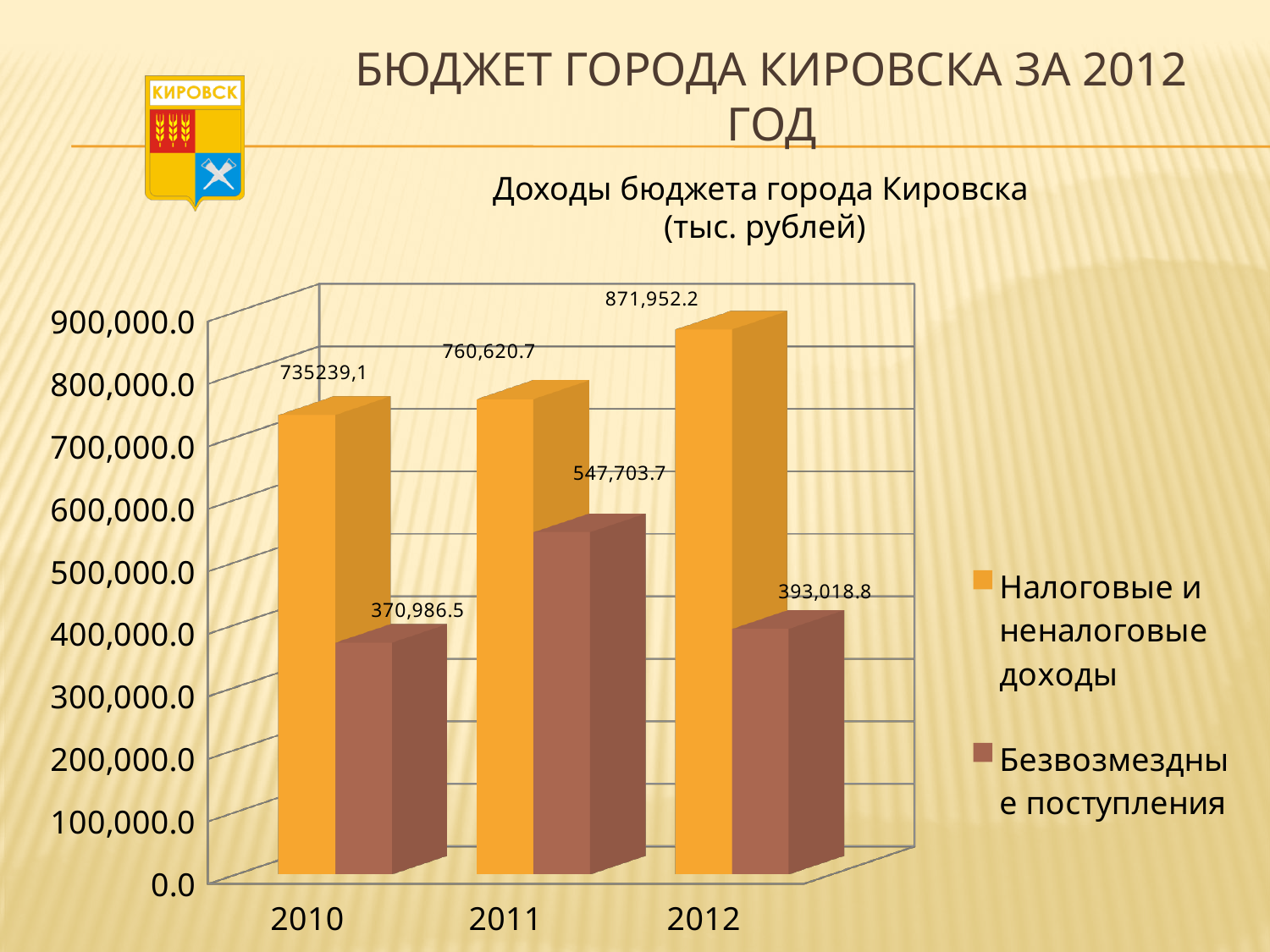
What is the value for Налоговые и неналоговые доходы in 2012? 871,952.2 Is the value for Безвозмездные поступления in 2012 greater or less than 400,000.0? less How many series does the legend list? 2 What is the difference between Безвозмездные поступления in 2011 and in 2012? 154,684.9 In which year is Налоговые и неналоговые доходы highest? 2012 What is the value for Безвозмездные поступления in 2010? 370,986.5 What is the value for Безвозмездные поступления in 2011? 547,703.7 What is the value for Налоговые и неналоговые доходы in 2011? 760,620.7 Which is larger in 2011: Налоговые и неналоговые доходы or Безвозмездные поступления? Налоговые и неналоговые доходы What is the difference between Налоговые и неналоговые доходы in 2012 and in 2011? 111,331.5 In which year is Безвозмездные поступления lowest? 2010 How many years are shown on the x axis? 3